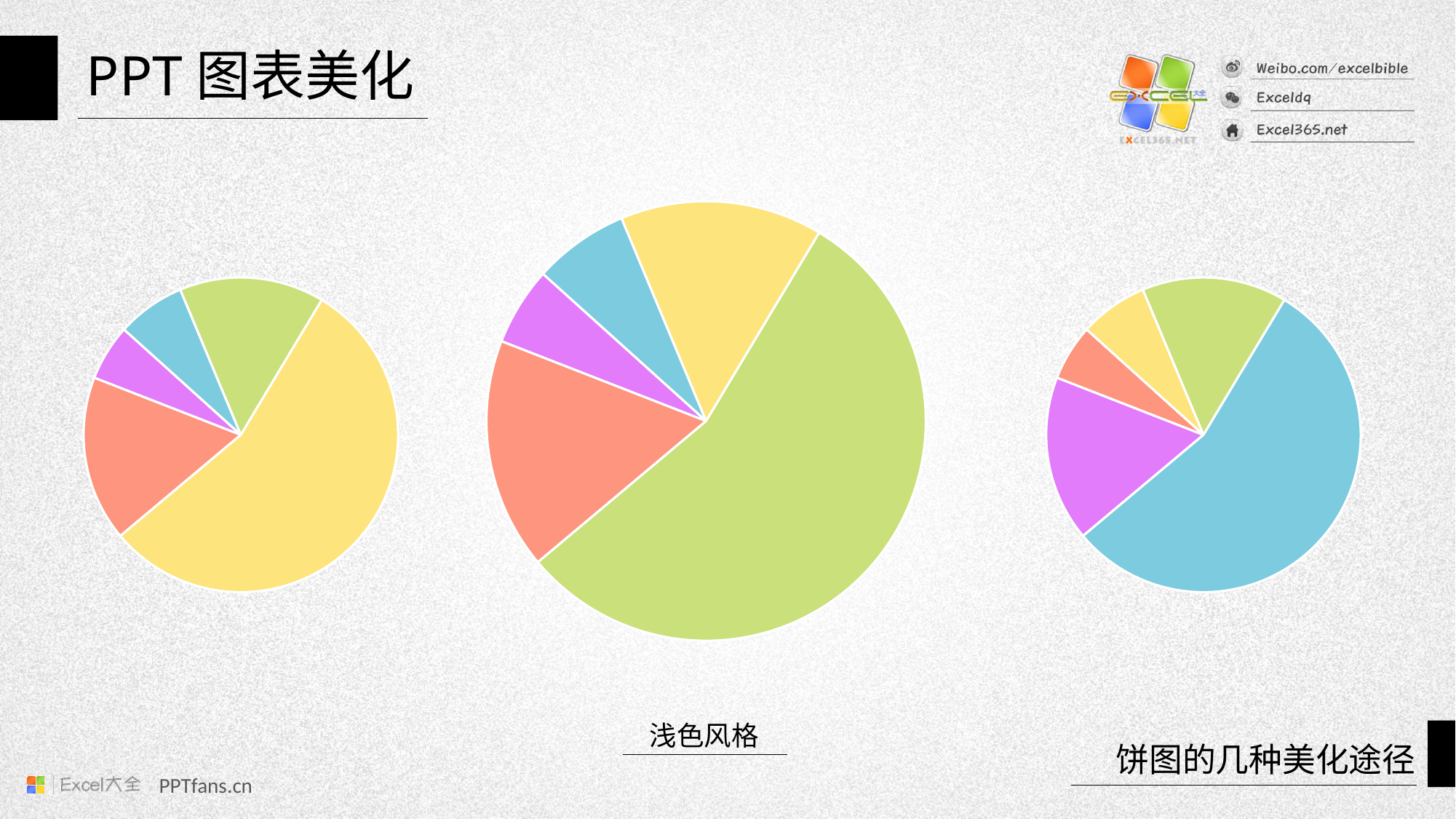
What caption is printed below the pie chart in the middle of the slide? 浅色风格 In the pie chart on the right of the slide, which slice is larger, the purple one or the green one? purple What kind of chart is the chart on the left of the slide? pie chart What kind of chart is the chart in the middle of the slide? pie chart In the pie chart on the right of the slide, which colour slice is the largest? blue How many slices does the pie chart on the right of the slide have? 5 How many slices does the pie chart in the middle of the slide have? 5 How many charts are shown on the slide? 3 In the pie chart in the middle of the slide, which colour slice is the largest? green In the pie chart on the left of the slide, which colour slice is the largest? yellow In the pie chart in the middle of the slide, which slice is larger, the red one or the blue one? red